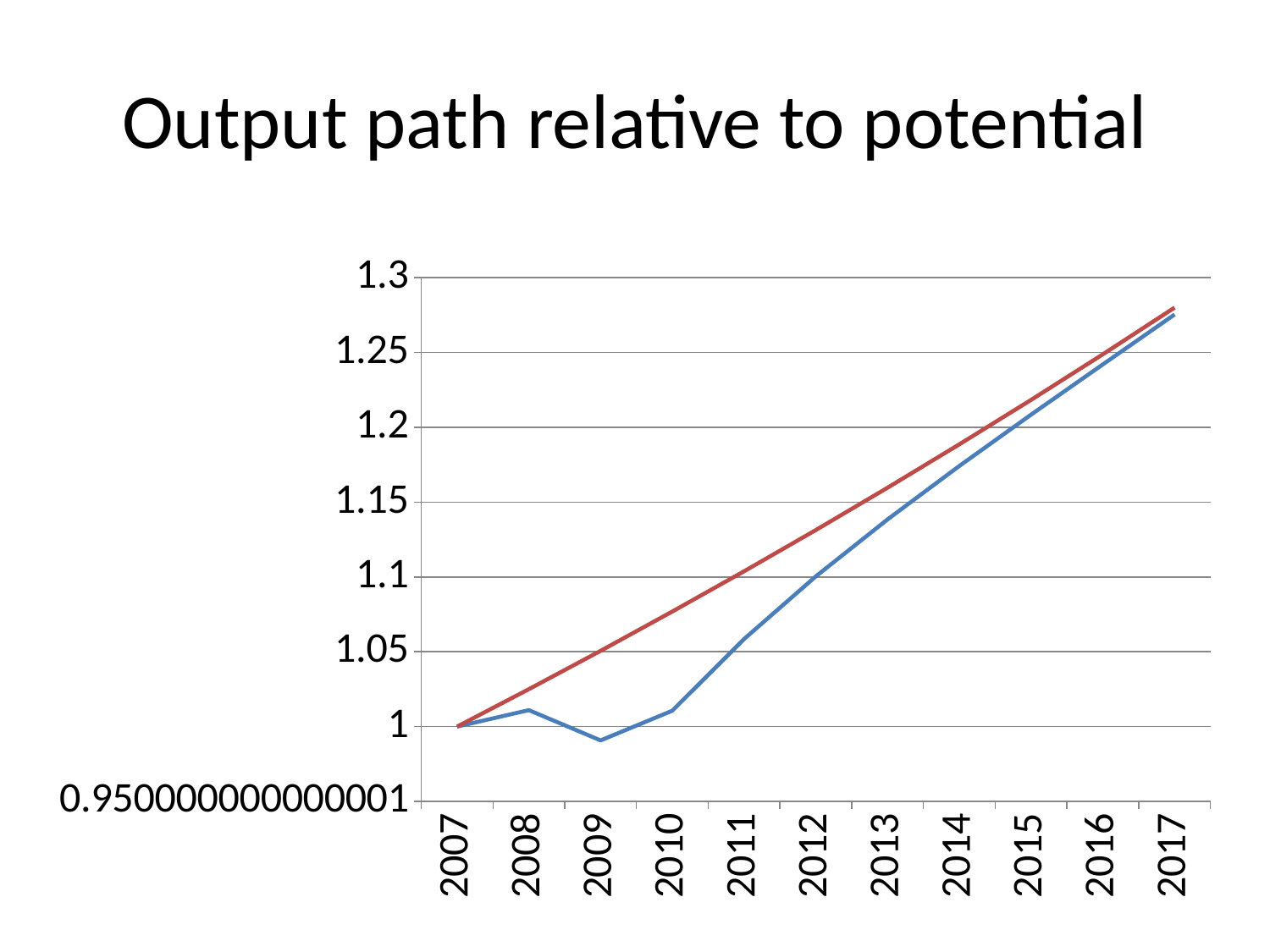
How many years are shown on the x axis? 11 In which year does the blue line reach its lowest value? 2009 How many lines are plotted on the chart? 2 Is the value of the blue line in 2017 greater or less than 1.25? greater What type of chart is shown on the slide? line chart In 2009, which line has the higher value, the red line or the blue line? the red line What is the value of the blue line in 2007? 1 Is the value of the blue line in 2009 greater or less than 1? less Is the value of the red line in 2012 greater or less than 1.1? greater In which year does the red line reach its highest value? 2017 What is the title of the chart? Output path relative to potential Does the red line rise or fall from 2007 to 2017? rise